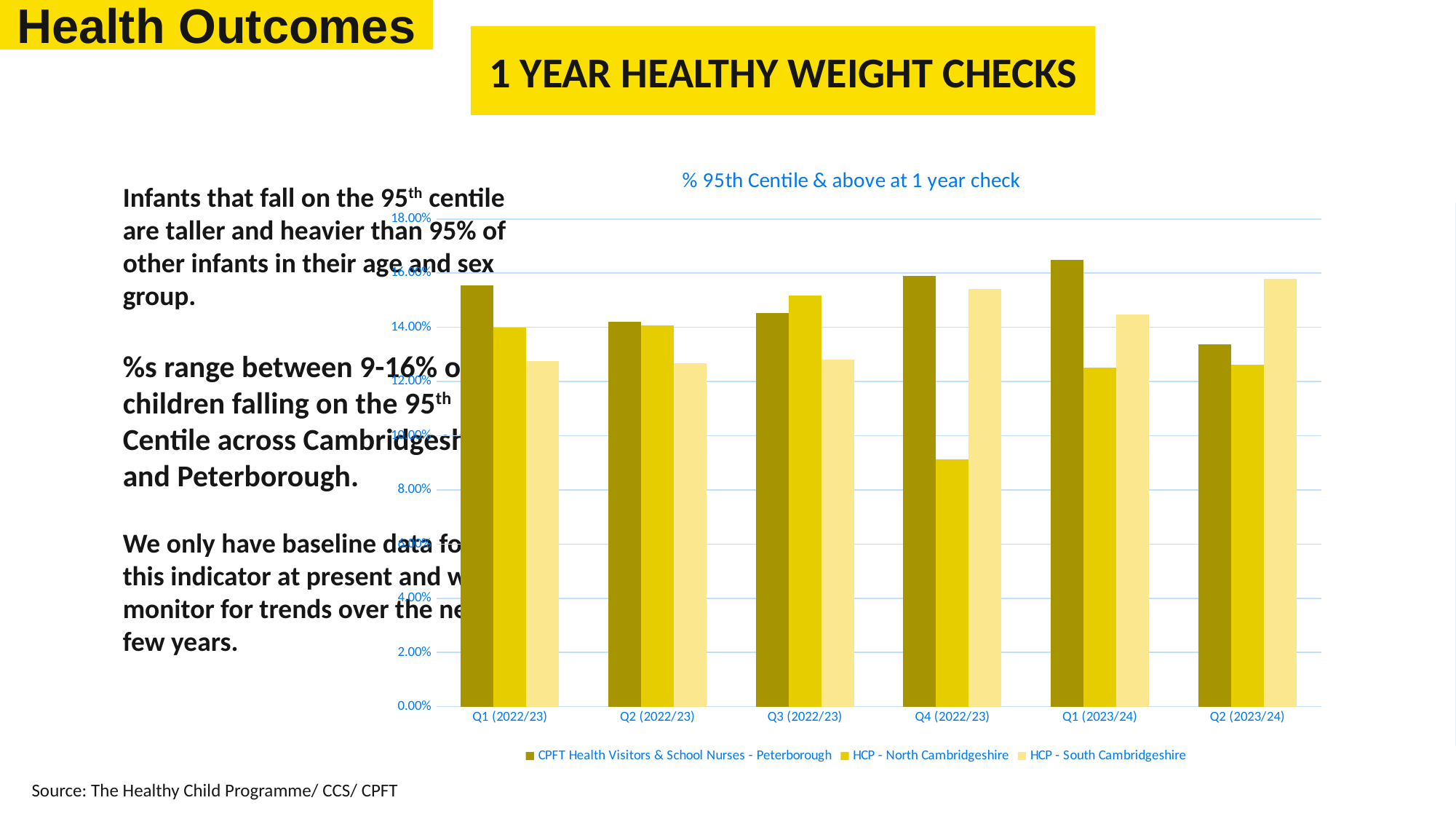
What type of chart is shown on the slide? bar chart In which quarter is the HCP - North Cambridgeshire bar lowest? Q4 (2022/23) How many quarters are shown on the x axis? 6 How many series does the legend list? 3 Is the value for CPFT Health Visitors & School Nurses - Peterborough in Q1 (2023/24) greater or less than 16.00%? greater Is the value for HCP - North Cambridgeshire in Q4 (2022/23) greater or less than 10.00%? less In Q2 (2023/24), which is larger: HCP - South Cambridgeshire or CPFT Health Visitors & School Nurses - Peterborough? HCP - South Cambridgeshire In which quarter is the CPFT Health Visitors & School Nurses - Peterborough bar highest? Q1 (2023/24) Is the value for HCP - South Cambridgeshire in Q1 (2022/23) greater or less than 14.00%? less What is the title of the chart? % 95th Centile & above at 1 year check Which series is shown in the lightest yellow colour? HCP - South Cambridgeshire Which series has the lowest bar in Q4 (2022/23)? HCP - North Cambridgeshire